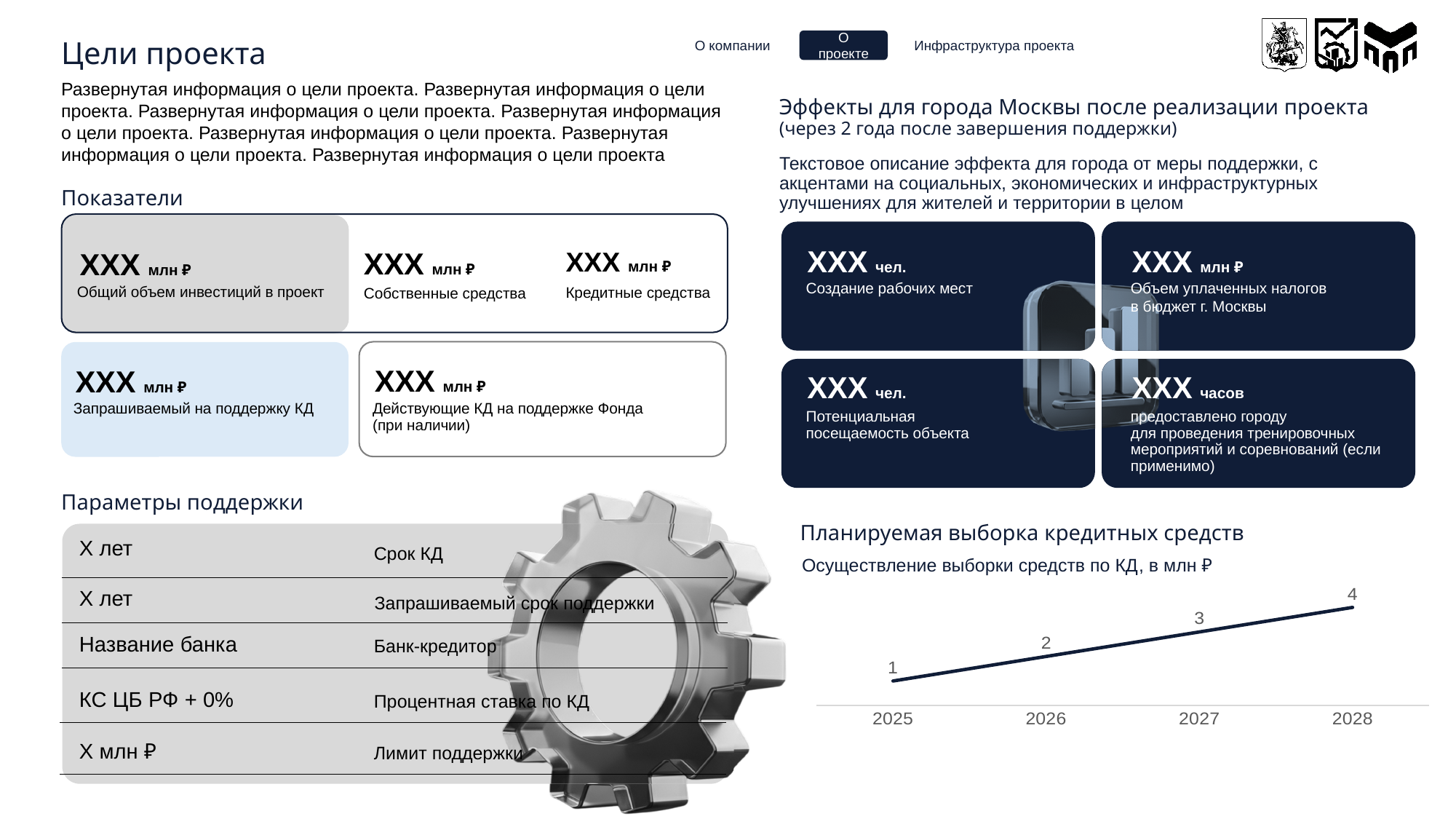
In the chart 'Планируемая выборка кредитных средств', which year has the lowest value? 2025 In the chart 'Планируемая выборка кредитных средств', which year has the highest value? 2028 What type of chart is shown under the heading 'Планируемая выборка кредитных средств'? line chart In the chart 'Планируемая выборка кредитных средств', what is the value for 2025? 1 In the chart 'Планируемая выборка кредитных средств', what is the value for 2026? 2 What unit is stated in the subtitle of the chart 'Планируемая выборка кредитных средств'? млн ₽ In the chart 'Планируемая выборка кредитных средств', what is the value for 2028? 4 In the chart 'Планируемая выборка кредитных средств', do the values rise or fall from 2025 to 2028? rise In the chart 'Планируемая выборка кредитных средств', what is the difference between the values for 2028 and 2025? 3 How many years are plotted on the x axis of the chart 'Планируемая выборка кредитных средств'? 4 In the chart 'Планируемая выборка кредитных средств', which is larger, the value for 2026 or the value for 2027? 2027 In the chart 'Планируемая выборка кредитных средств', what is the value for 2027? 3